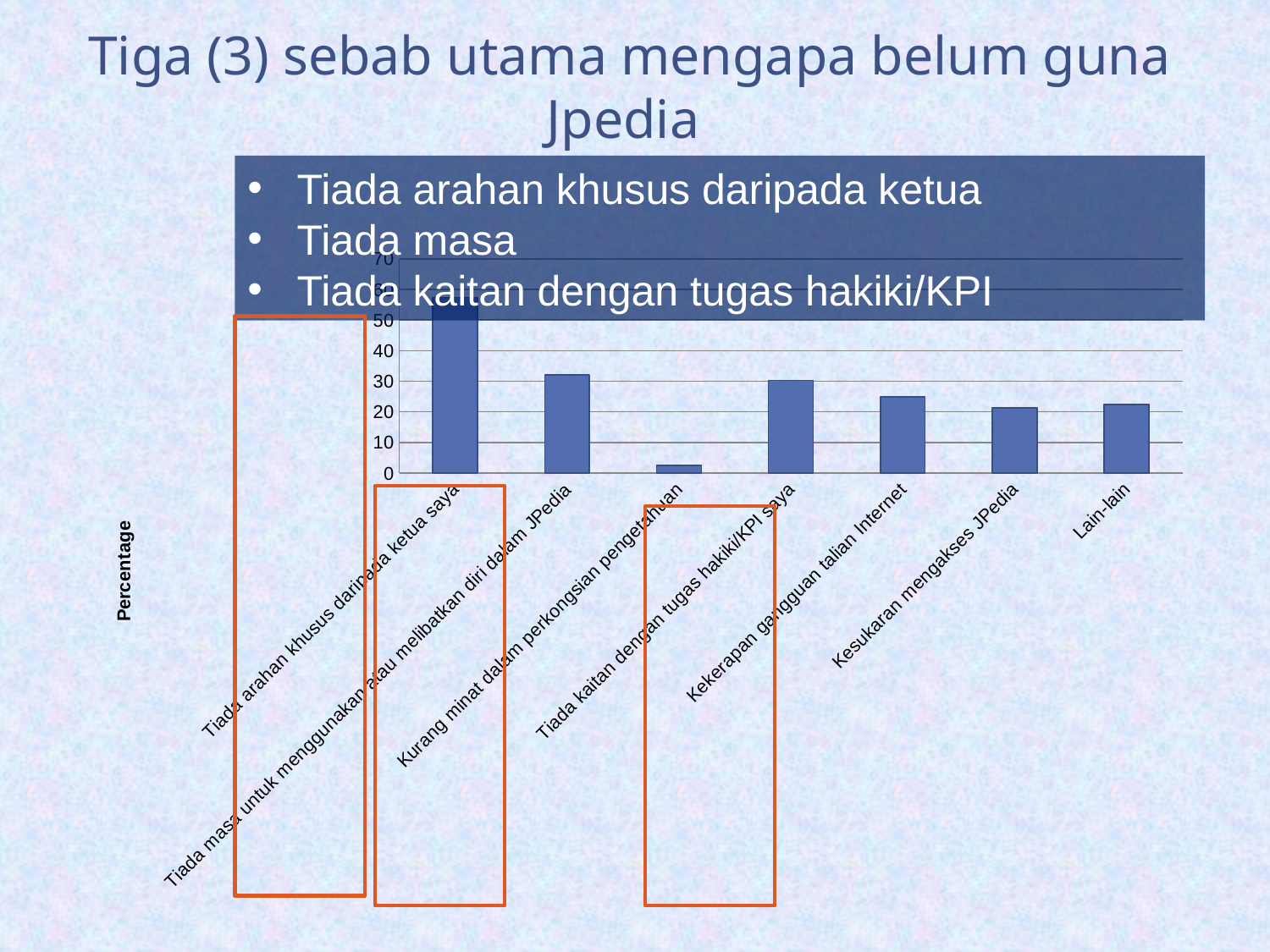
Which category has the highest value in the chart? Tiada arahan khusus daripada ketua saya Is the value for "Kurang minat dalam perkongsian pengetahuan" greater or less than 10? less Which is larger: the value for "Kurang minat dalam perkongsian pengetahuan" or the value for "Kesukaran mengakses JPedia"? Kesukaran mengakses JPedia Which is larger: the value for "Tiada masa untuk menggunakan atau melibatkan diri dalam JPedia" or the value for "Kekerapan gangguan talian Internet"? Tiada masa untuk menggunakan atau melibatkan diri dalam JPedia Is the value for "Tiada arahan khusus daripada ketua saya" greater or less than 50? greater Is the value for "Lain-lain" greater or less than 30? less What is the label on the vertical axis of the chart? Percentage Which category has the lowest value in the chart? Kurang minat dalam perkongsian pengetahuan How many categories (bars) does the chart show? 7 What kind of chart is shown on the slide? bar chart